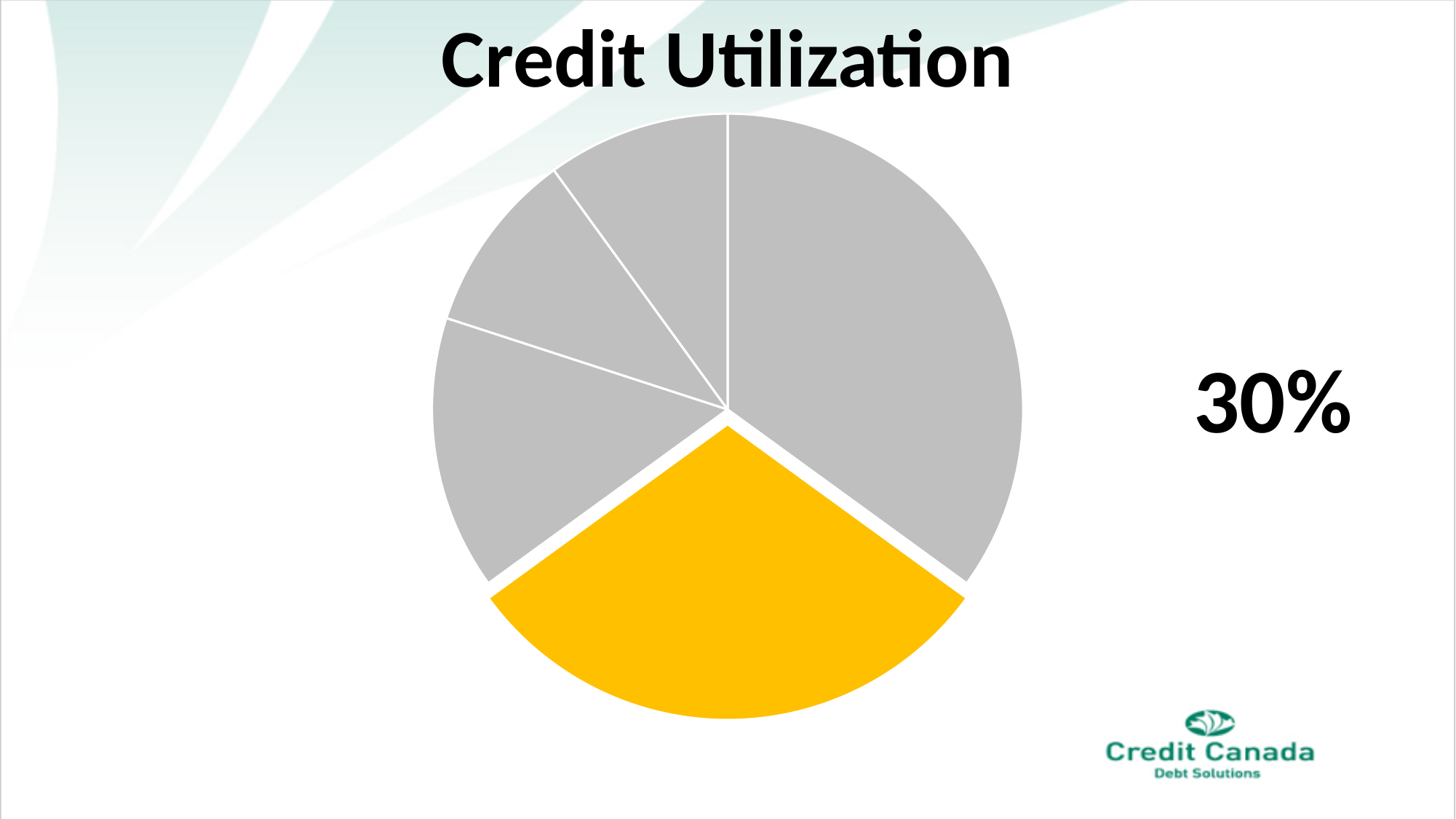
What colour is the slice that is pulled out from the rest of the pie? yellow Which slice is the largest in the pie chart? the large grey slice on the right What kind of chart is shown on the slide? pie chart How many slices does the pie chart have? 5 What is the title of the chart? Credit Utilization Which is larger, the yellow slice or the grey slice on the left side of the pie? the yellow slice How many slices of the pie are coloured grey? 4 What percentage is printed to the right of the pie chart? 30%